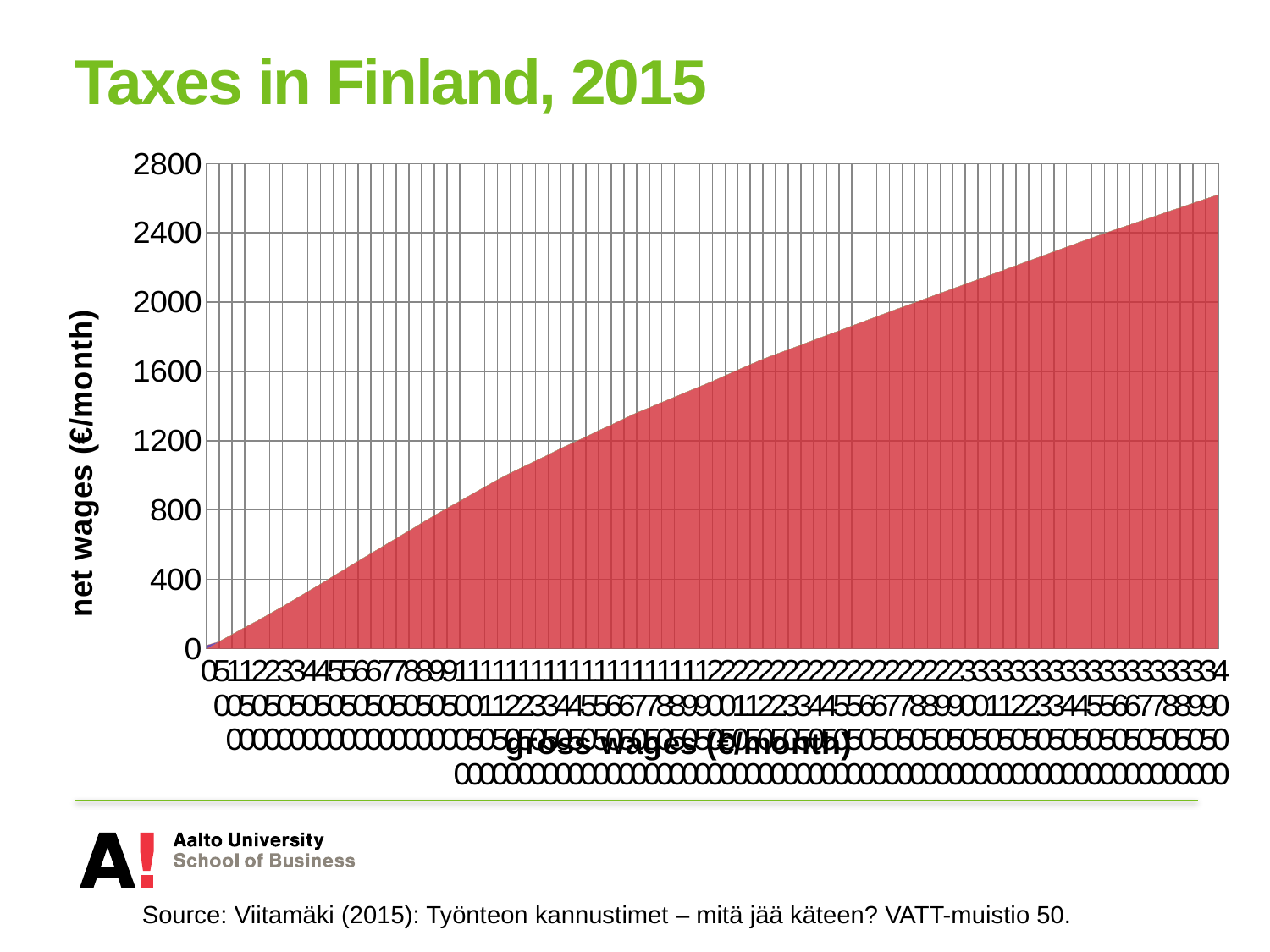
What kind of chart is shown on the slide? area chart What is the label of the vertical axis? net wages (€/month) Is the highest plotted net wage value greater or less than 2800? less Do net wages rise or fall as gross wages increase along the x axis? rise What is the title of the slide containing the chart? Taxes in Finland, 2015 Is the highest plotted net wage value greater or less than 2400? greater